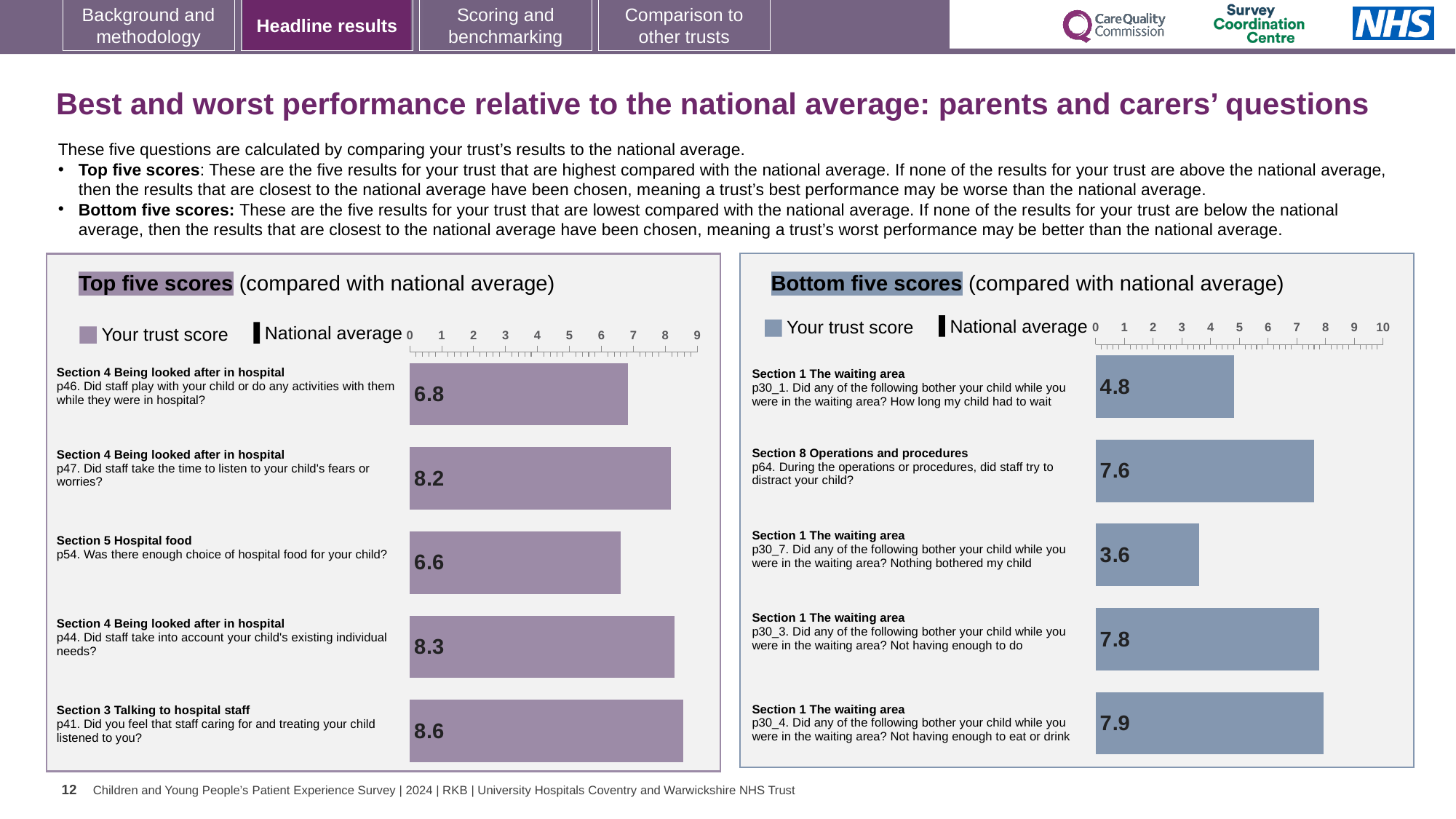
In the Bottom five scores chart, which is larger: the trust score for p30_1 (How long my child had to wait) or for p30_3 (Not having enough to do)? p30_3 (Not having enough to do) In the Top five scores chart, which question has the lowest trust score? p54. Was there enough choice of hospital food for your child? In the Bottom five scores chart, which question has the lowest trust score? p30_7. Did any of the following bother your child while you were in the waiting area? Nothing bothered my child In the Bottom five scores chart, what is the trust score for p30_7 (Nothing bothered my child)? 3.6 In the Top five scores chart, what is the difference between the trust scores for p41 and p54? 2.0 What type of chart is the Top five scores chart? Bar chart In the Top five scores chart, how many questions are shown? 5 In the Top five scores chart, what is the trust score for p46 (Did staff play with your child or do any activities with them while they were in hospital)? 6.8 In the Top five scores chart, which question has the highest trust score? p41. Did you feel that staff caring for and treating your child listened to you? In the Bottom five scores chart, what is the trust score for p64 (During the operations or procedures, did staff try to distract your child)? 7.6 In the Bottom five scores chart, what is the difference between the trust scores for p30_4 and p30_1? 3.1 In the Top five scores chart, what is the trust score for p41 (Did you feel that staff caring for and treating your child listened to you)? 8.6